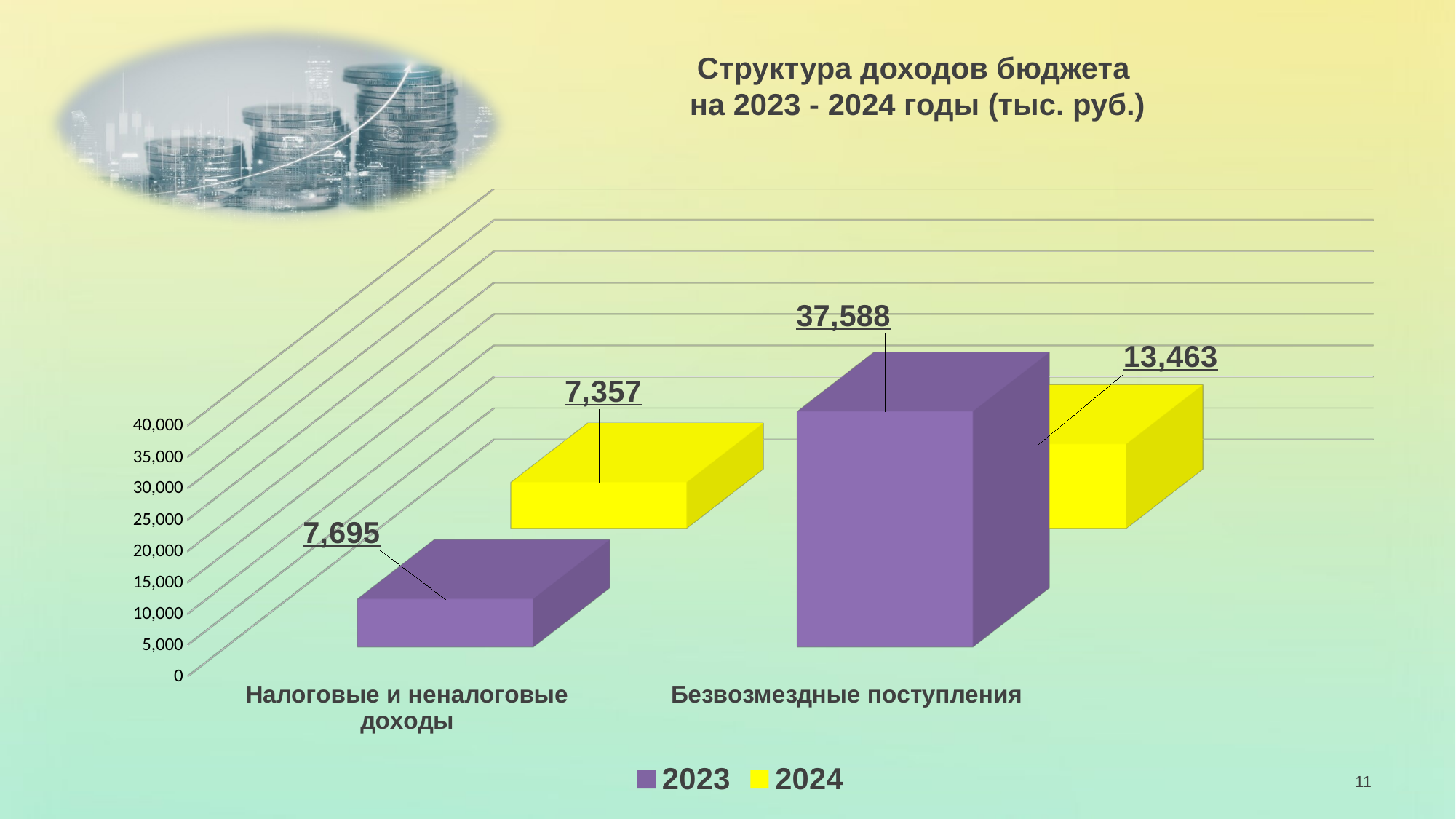
Which is larger for "Безвозмездные поступления": the 2023 value or the 2024 value? 2023 How many categories are shown on the x axis? 2 What is the value for 2023 in the category "Налоговые и неналоговые доходы"? 7,695 What is the difference between the 2023 and 2024 values for "Безвозмездные поступления"? 24,125 How many series does the legend list? 2 Which bar has the highest value on the chart? 2023, Безвозмездные поступления What type of chart is shown on the slide? Bar chart What is the value for 2024 in the category "Безвозмездные поступления"? 13,463 Which bar has the lowest value on the chart? 2024, Налоговые и неналоговые доходы What is the value for 2023 in the category "Безвозмездные поступления"? 37,588 What is the value for 2024 in the category "Налоговые и неналоговые доходы"? 7,357 What is the difference between the 2023 and 2024 values for "Налоговые и неналоговые доходы"? 338